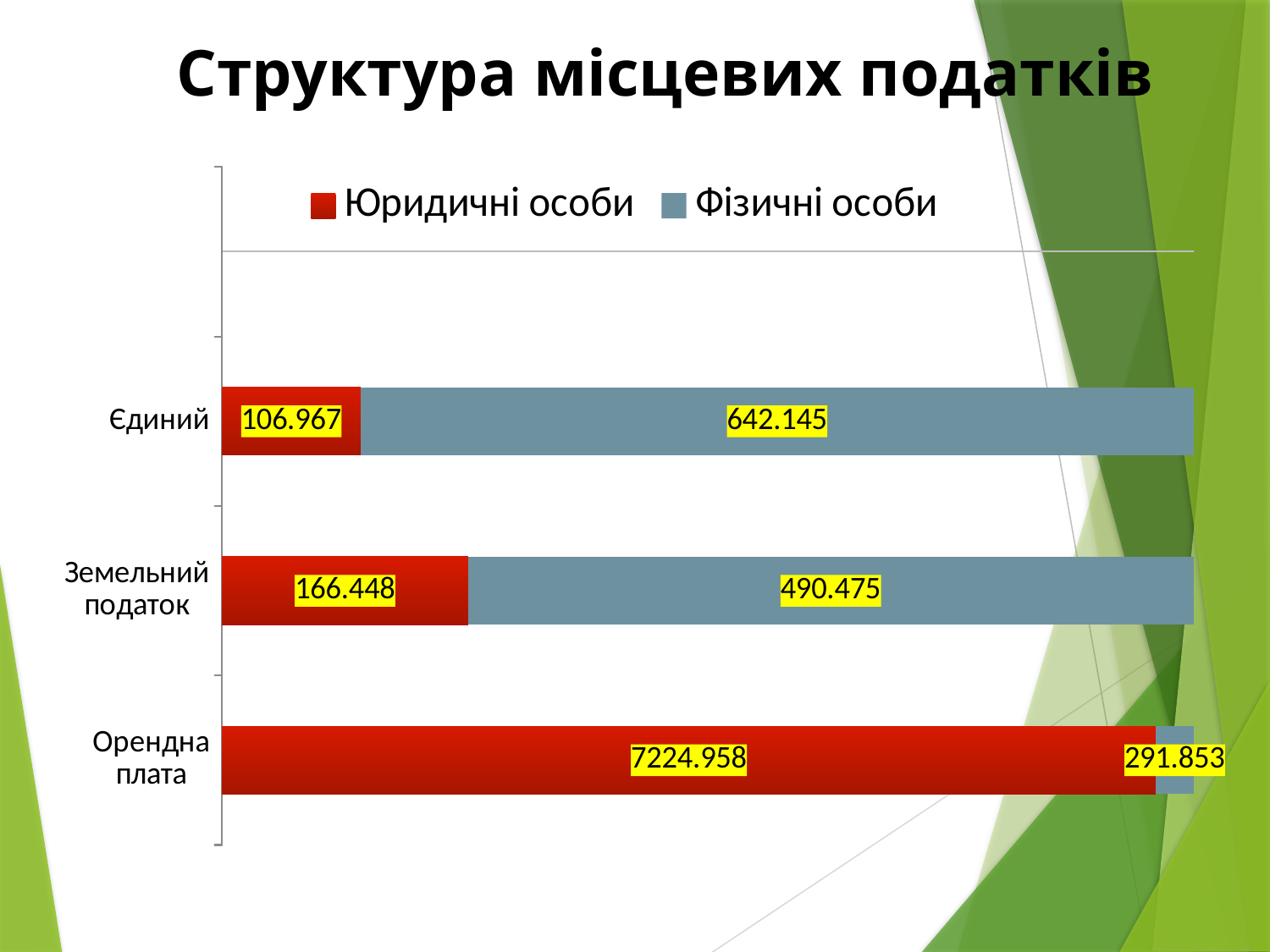
Which category has the lowest value for Фізичні особи? Орендна плата What is the value for Фізичні особи in the Орендна плата category? 291.853 What is the total of the Орендна плата bar (Юридичні особи plus Фізичні особи)? 7516.811 What is the value for Юридичні особи in the Орендна плата category? 7224.958 What is the value for Фізичні особи in the Земельний податок category? 490.475 What is the difference between Фізичні особи and Юридичні особи in the Єдиний category? 535.178 Which category has the highest value for Юридичні особи? Орендна плата How many categories are shown on the chart? 3 In the Земельний податок category, which is larger: Юридичні особи or Фізичні особи? Фізичні особи What kind of chart is shown on the slide? Stacked bar chart What is the value for Юридичні особи in the Єдиний category? 106.967 How many series does the legend list? 2